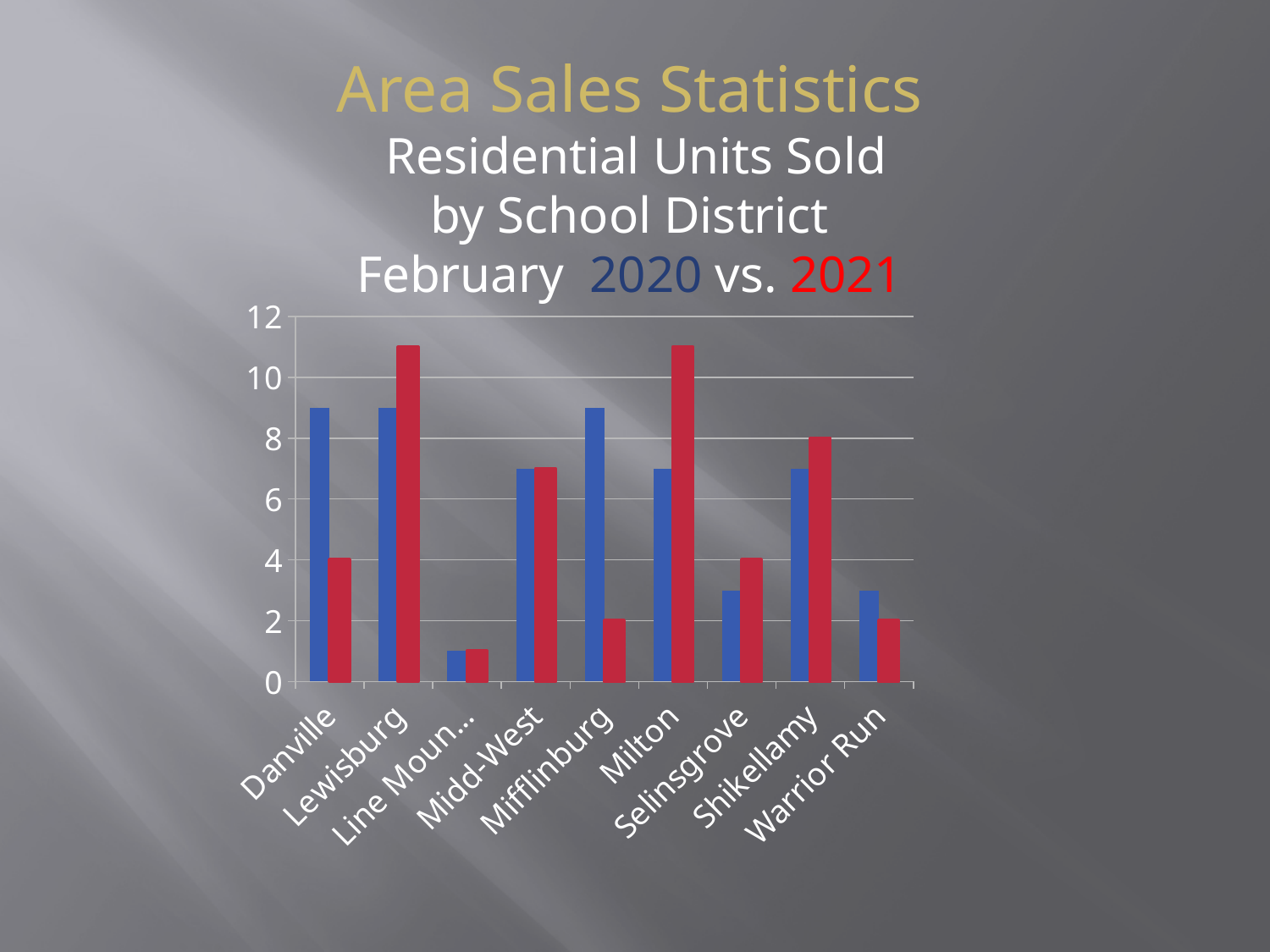
How many school districts are shown on the x axis of the chart? 9 What is the 2021 value for Danville? 4 How many years (series) does the chart compare? 2 What is the 2021 value for Warrior Run? 2 What kind of chart is shown on the slide? bar chart What is the difference between the 2021 values for Shikellamy and Danville? 4 What is the 2021 value for Mifflinburg? 2 Is the 2020 value for Warrior Run greater or less than 4? less What is the 2021 value for Shikellamy? 8 Is the 2021 value for Lewisburg greater or less than 10? greater For Milton, which year has the larger value, 2020 or 2021? 2021 Which colour represents 2021 in the chart? red